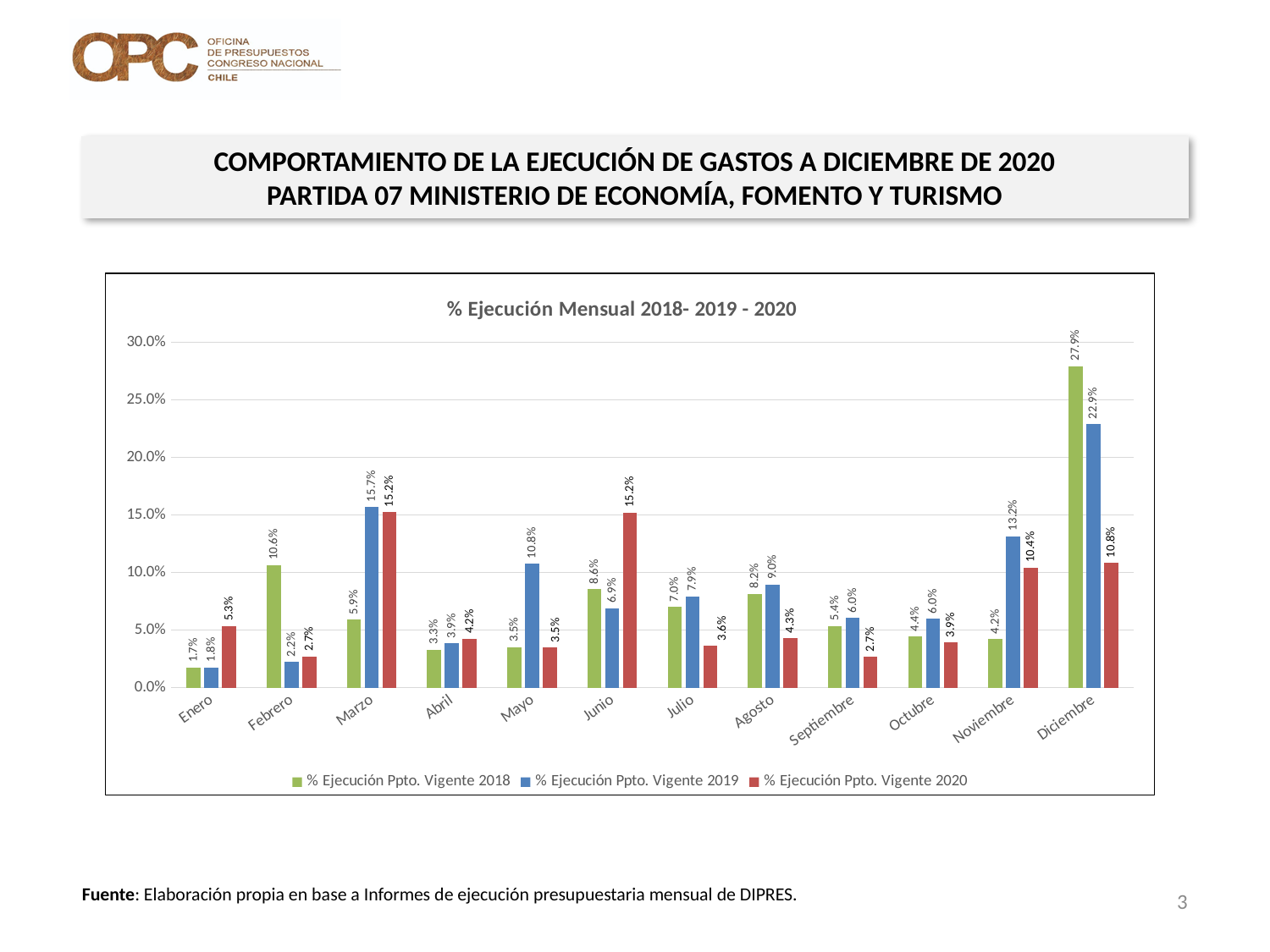
Which is larger in Junio: the 2018 value or the 2020 value? the 2020 value What is the difference between the 2018 and 2019 values in Diciembre? 5.0% What is the value for % Ejecución Ppto. Vigente 2020 in Enero? 5.3% What type of chart is shown on the slide? bar chart Which month has the lowest value for % Ejecución Ppto. Vigente 2019? Enero What is the value for % Ejecución Ppto. Vigente 2019 in Noviembre? 13.2% Is the value for % Ejecución Ppto. Vigente 2019 in Marzo greater or less than 15.0%? greater How many months are shown on the x axis? 12 Which month has the highest value for % Ejecución Ppto. Vigente 2018? Diciembre How many series does the legend list? 3 What is the value for % Ejecución Ppto. Vigente 2018 in Febrero? 10.6% What is the title of the chart? % Ejecución Mensual 2018- 2019 - 2020